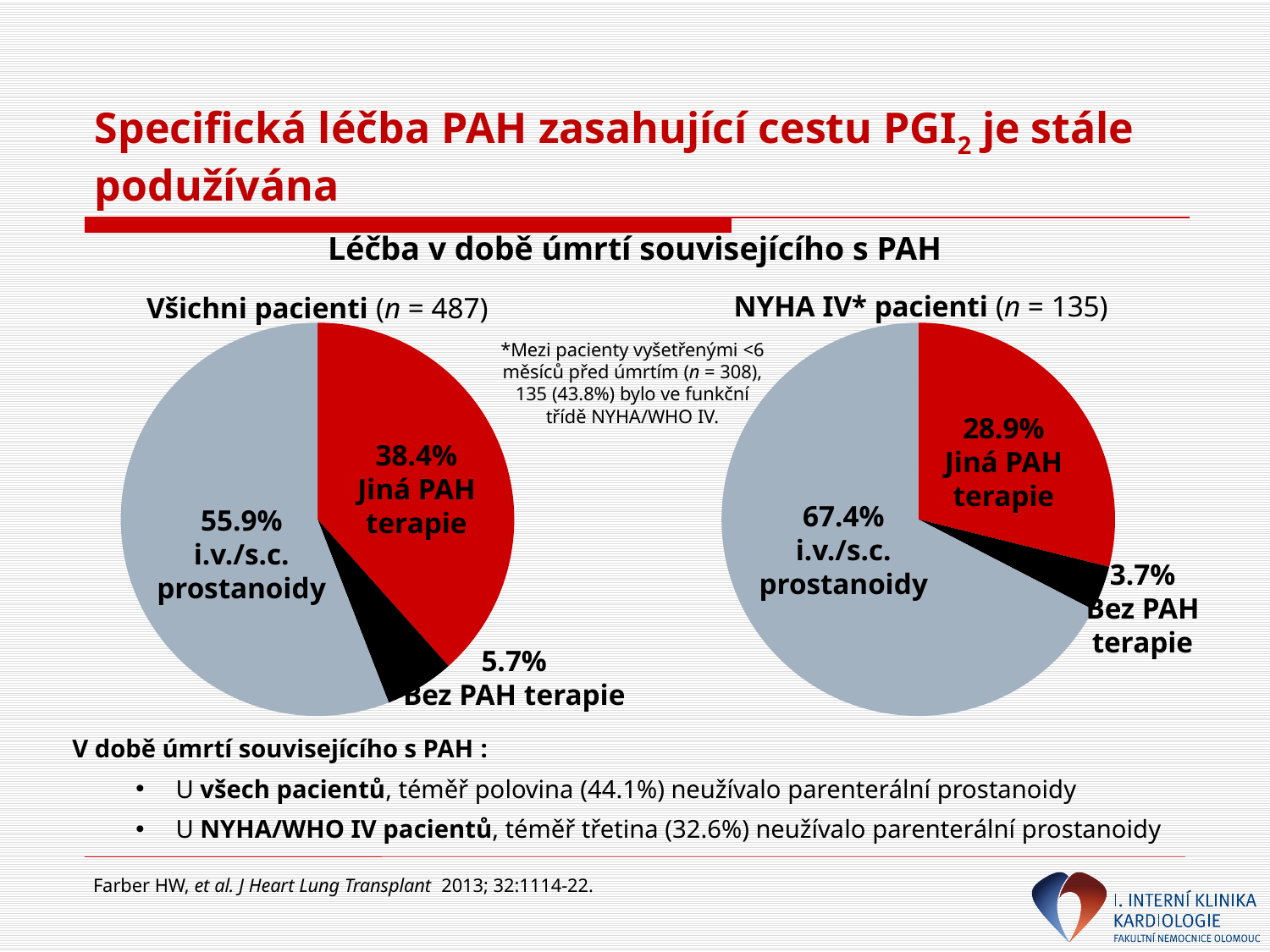
What is the number of patients (n) given in the title of the right pie chart? 135 In the right pie chart (NYHA IV* pacienti), what share is labelled for i.v./s.c. prostanoidy? 67.4% In the left pie chart (Všichni pacienti), what share is labelled for i.v./s.c. prostanoidy? 55.9% In the left pie chart (Všichni pacienti), what share is labelled for Jiná PAH terapie? 38.4% Which chart shows a larger share for Jiná PAH terapie, the left (Všichni pacienti) or the right (NYHA IV* pacienti)? Left (Všichni pacienti) In the right pie chart (NYHA IV* pacienti), what is the difference in percentage points between Jiná PAH terapie and Bez PAH terapie? 25.2 What type of chart is used for the NYHA IV* pacienti data? Pie chart How many slices does the left pie chart (Všichni pacienti) have? 3 In the left pie chart (Všichni pacienti), what is the difference in percentage points between i.v./s.c. prostanoidy and Jiná PAH terapie? 17.5 In the right pie chart (NYHA IV* pacienti), what share is labelled for Bez PAH terapie? 3.7% In the left pie chart (Všichni pacienti), which category has the smallest slice? Bez PAH terapie In the right pie chart (NYHA IV* pacienti), which category has the largest slice? i.v./s.c. prostanoidy